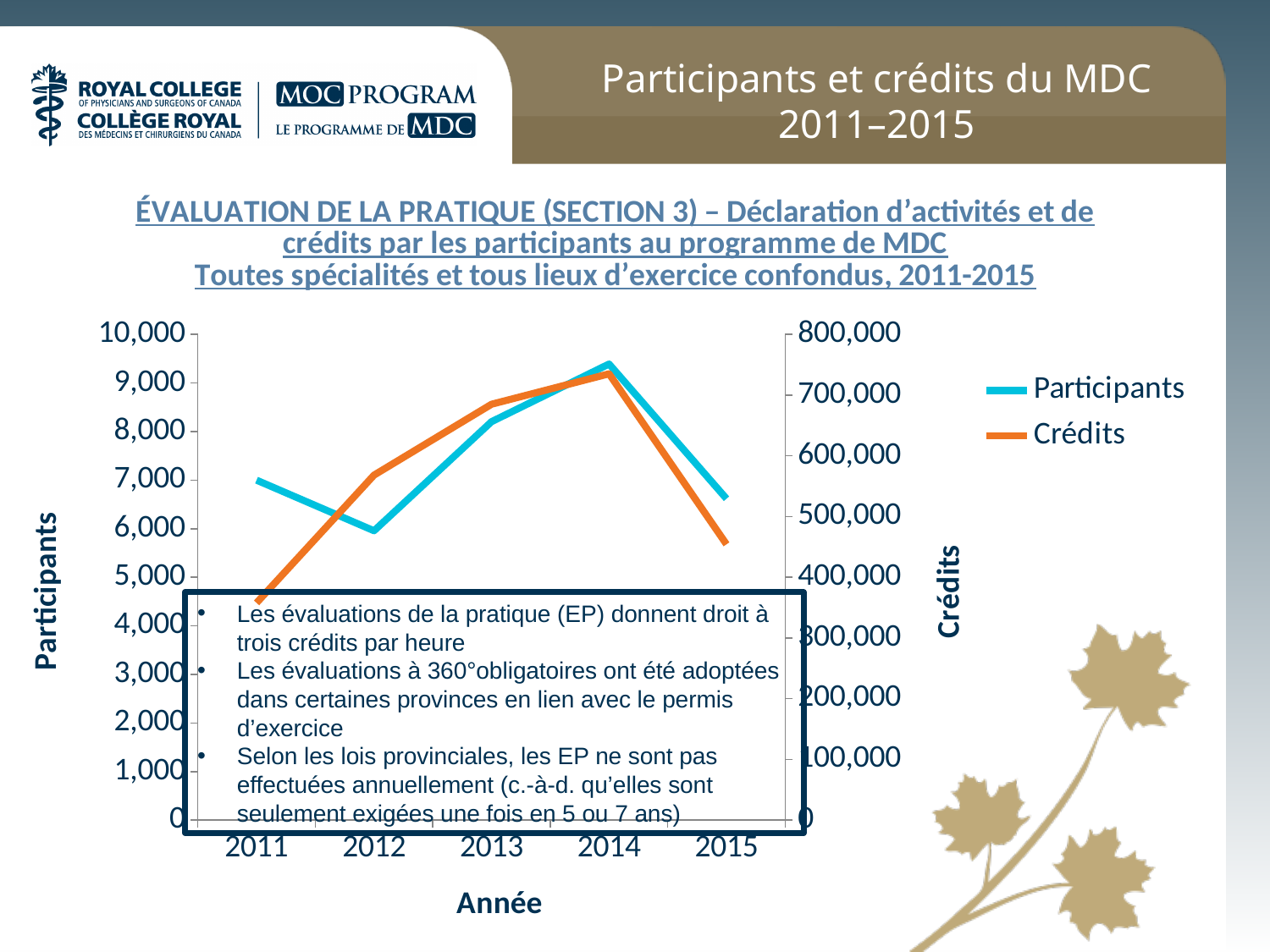
Is the value for Crédits in 2015 greater or less than 500,000? less Is the value for Participants in 2015 greater or less than 7,000? less In which year is the value for Crédits highest? 2014 In which year is the number of Participants lowest? 2012 Which year has more Participants, 2011 or 2012? 2011 Do the values for Crédits rise or fall from 2014 to 2015? fall Is the value for Crédits in 2014 greater or less than 700,000? greater How many series does the legend list? 2 How many years are plotted along the x axis? 5 What kind of chart is shown on the slide? line chart In which year is the number of Participants highest? 2014